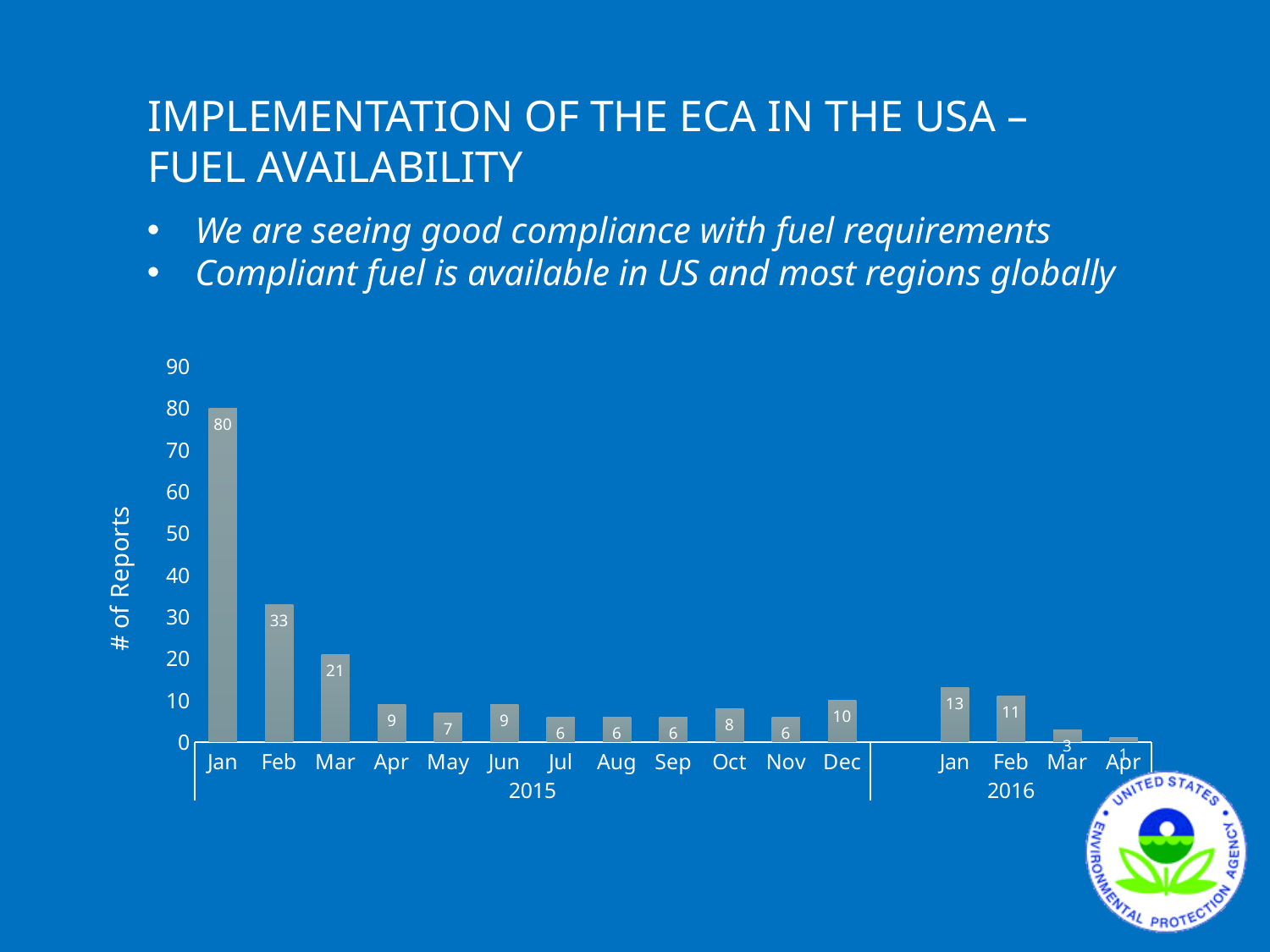
What kind of chart is shown on the slide? Bar chart What is the number of reports for Jan 2016? 13 Which month has the highest number of reports? Jan 2015 What is the number of reports for Jan 2015? 80 How many months (bars) are shown in the chart? 16 What is the difference in number of reports between Mar 2015 and Mar 2016? 18 Which has more reports, Feb 2016 or Oct 2015? Feb 2016 What is the number of reports for Dec 2015? 10 What is the label of the vertical axis of the chart? # of Reports What is the number of reports for Feb 2015? 33 What is the difference in number of reports between Jan 2015 and Feb 2015? 47 Which month has the lowest number of reports? Apr 2016